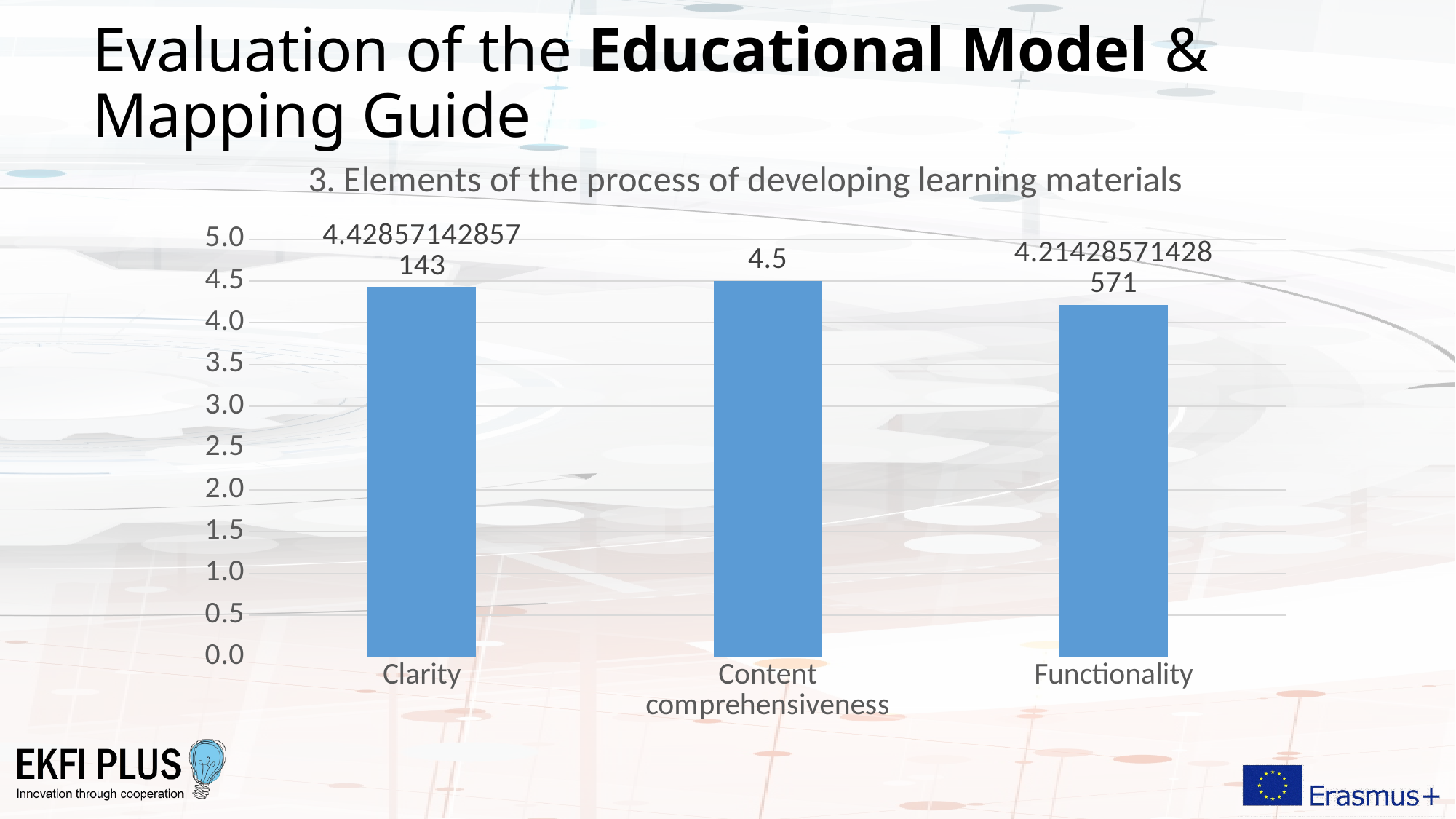
Which is larger, the value for Clarity or the value for Functionality? Clarity How many categories are shown in the chart? 3 What is the title of the chart? 3. Elements of the process of developing learning materials Which category has the lowest value? Functionality What is the value for Functionality? 4.21428571428571 What is the value for Clarity? 4.42857142857143 Is the value for Clarity greater or less than 4.0? greater What is the difference between the values for Content comprehensiveness and Functionality? 0.28571428571429 What kind of chart is shown on the slide? bar chart Is the value for Functionality greater or less than 4.5? less What is the value for Content comprehensiveness? 4.5 Which category has the highest value? Content comprehensiveness